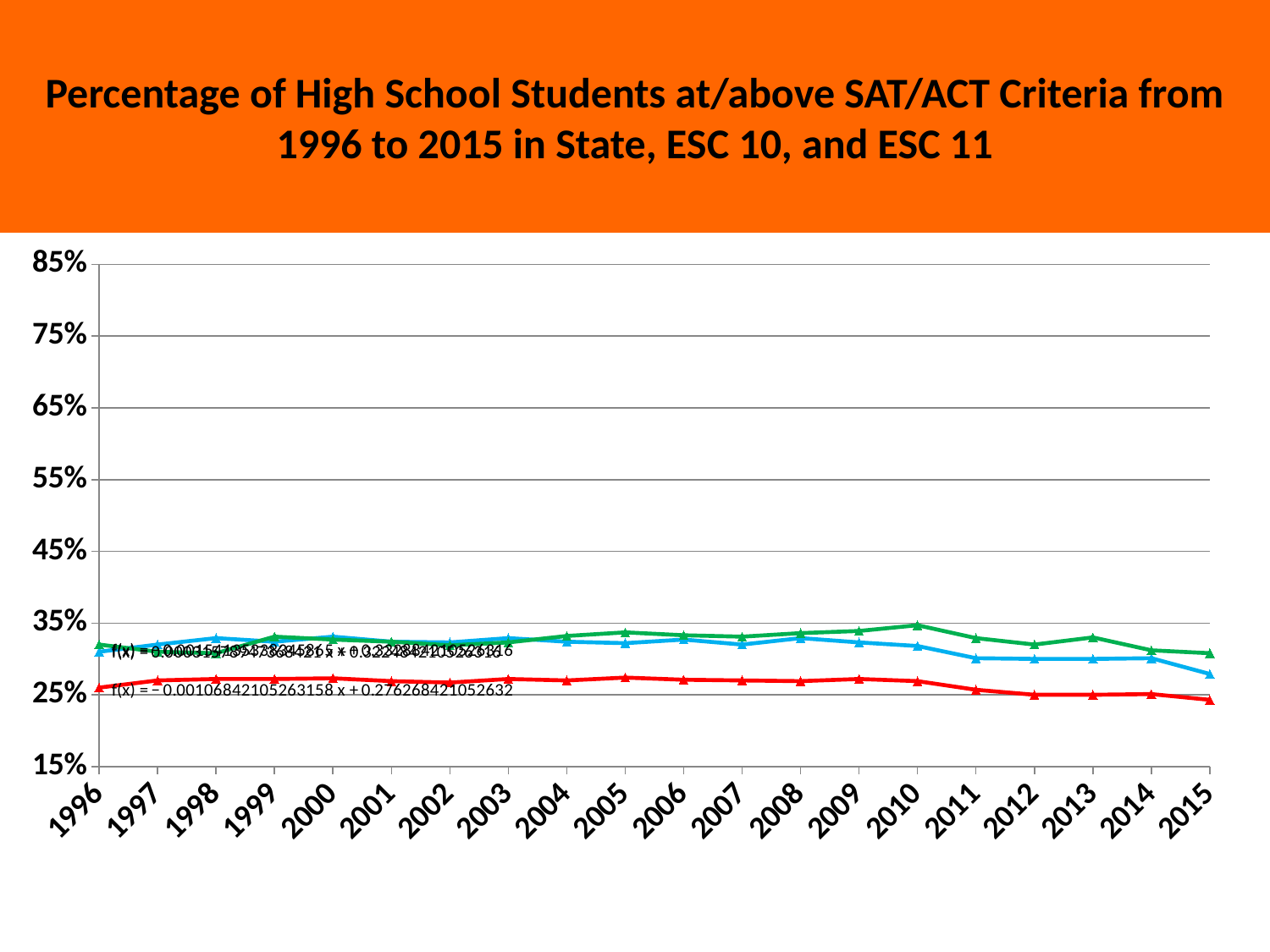
Is the value of the blue line in 2015 greater or less than 35%? less Does the red line rise or fall from 2010 to 2015? fall What is the first year shown on the x axis? 1996 Is the value of the green line in 2005 greater or less than 25%? greater How many lines are plotted on the chart? 3 What kind of chart is shown on the slide? line chart Is the value of the green line in 2010 greater or less than 45%? less What is the title of the chart? Percentage of High School Students at/above SAT/ACT Criteria from 1996 to 2015 in State, ESC 10, and ESC 11 In which year does the green line reach its highest value? 2010 How many years are shown along the x axis? 20 In 2010, which line has the larger value, the green line or the red line? green line